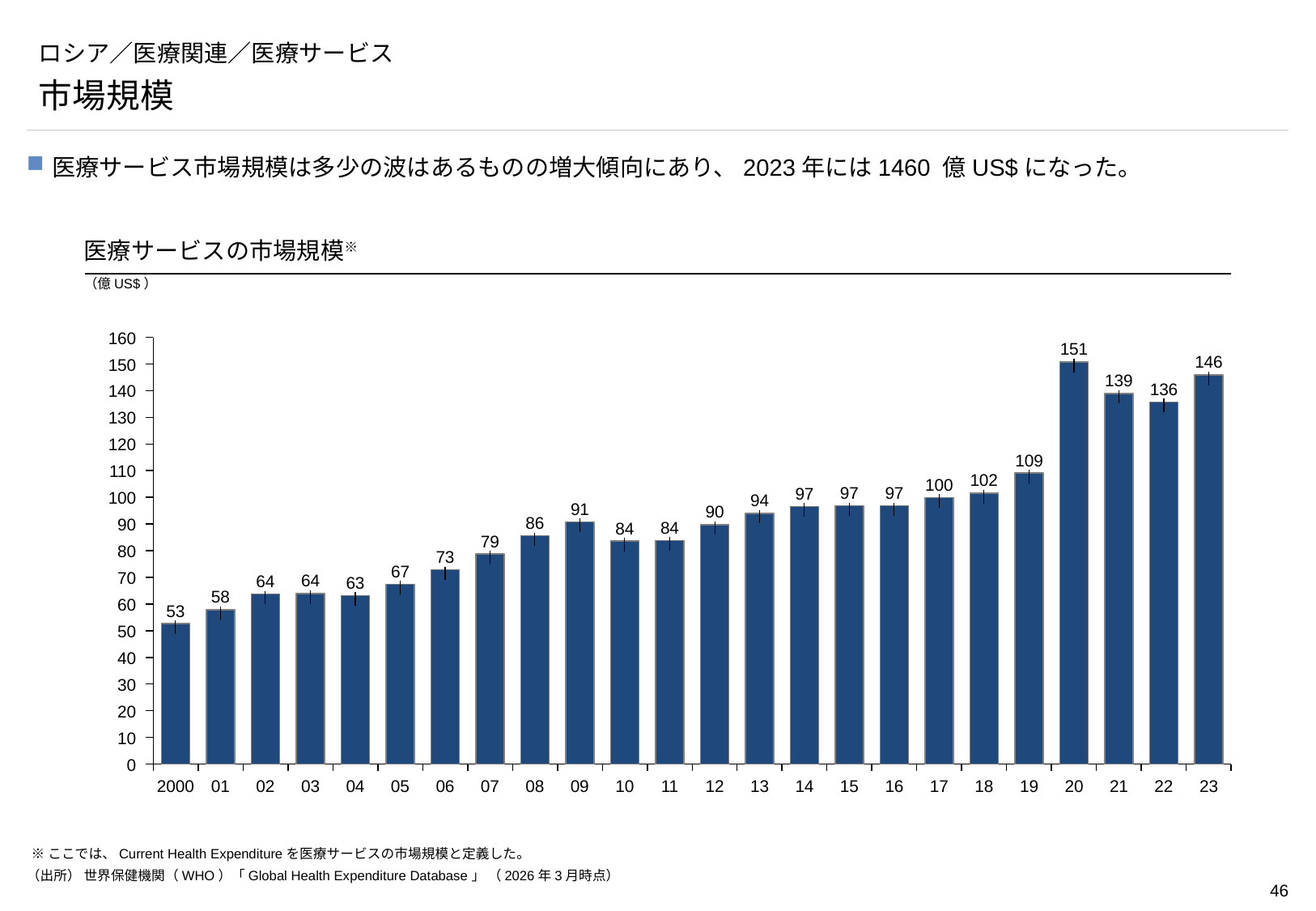
What is the difference between the values for 2023 and 2022? 10 Is the value for 2018 greater or less than 100? greater What is the difference between the values for 2020 and 2019? 42 What is the value for 2000 in the chart? 53 Which year has the highest value in the chart? 2020 What unit is shown for the values in the chart? 億US$ Which is larger, the value for 2021 or the value for 2023? 2023 What kind of chart is shown on the slide? Bar chart Which year has the lowest value in the chart? 2000 How many bars (years) are shown in the chart? 24 What is the value for 2023 in the chart? 146 What is the value for 2009 in the chart? 91